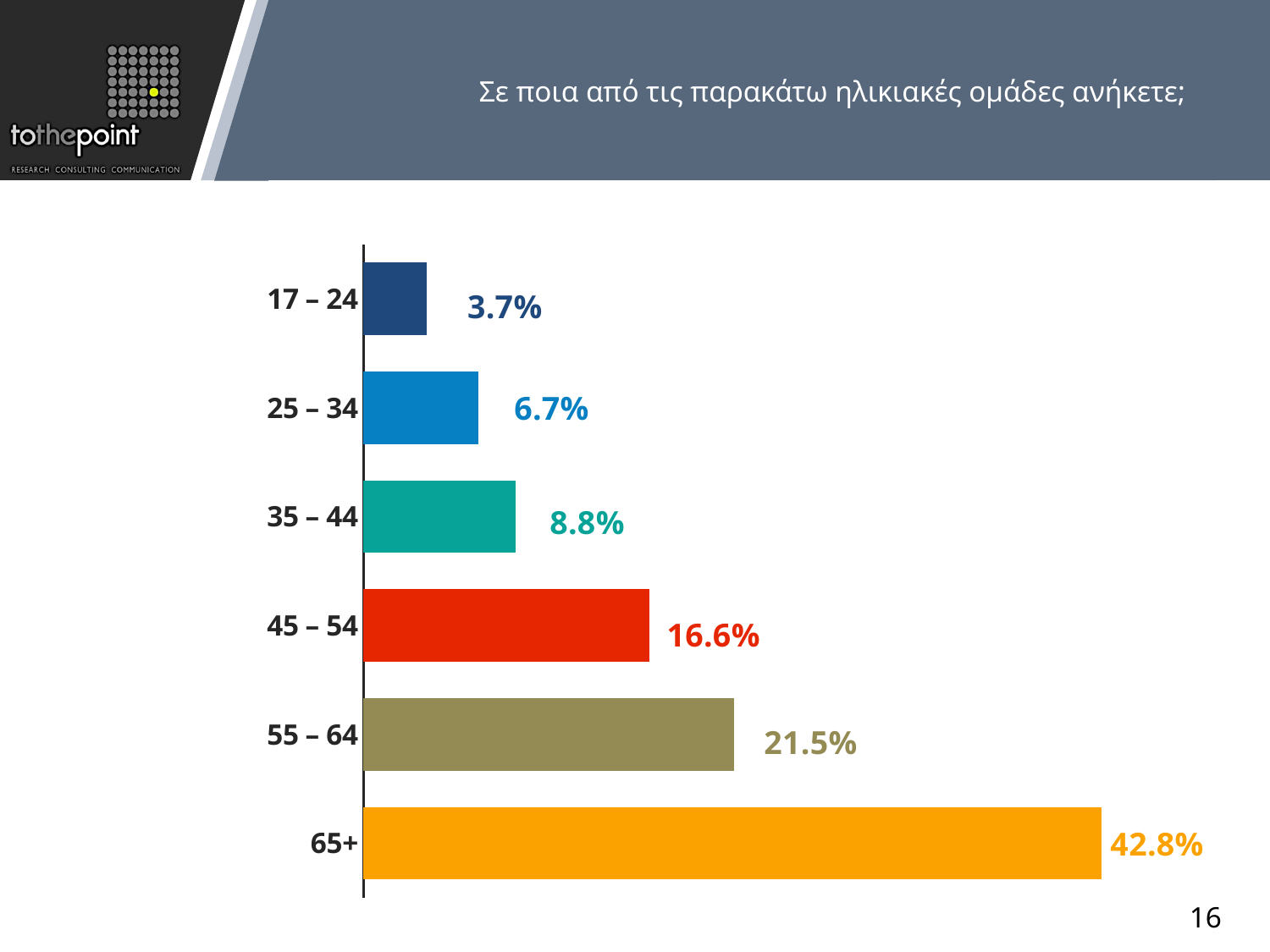
What is the difference between the 55 – 64 and 45 – 54 age groups? 4.9% Which age group has the highest percentage? 65+ Which age group has the lowest percentage? 17 – 24 Which is larger, the value for 25 – 34 or the value for 35 – 44? 35 – 44 What is the difference between the 65+ and 55 – 64 age groups? 21.3% Do the values increase or decrease going from the 17 – 24 group down to the 65+ group? Increase What type of chart is shown on the slide? Bar chart What is the value shown for the 17 – 24 age group? 3.7% What percentage of respondents are in the 65+ age group? 42.8% What colour is the bar for the 65+ age group? Orange How many age groups are shown in the chart? 6 What is the value shown for the 45 – 54 age group? 16.6%